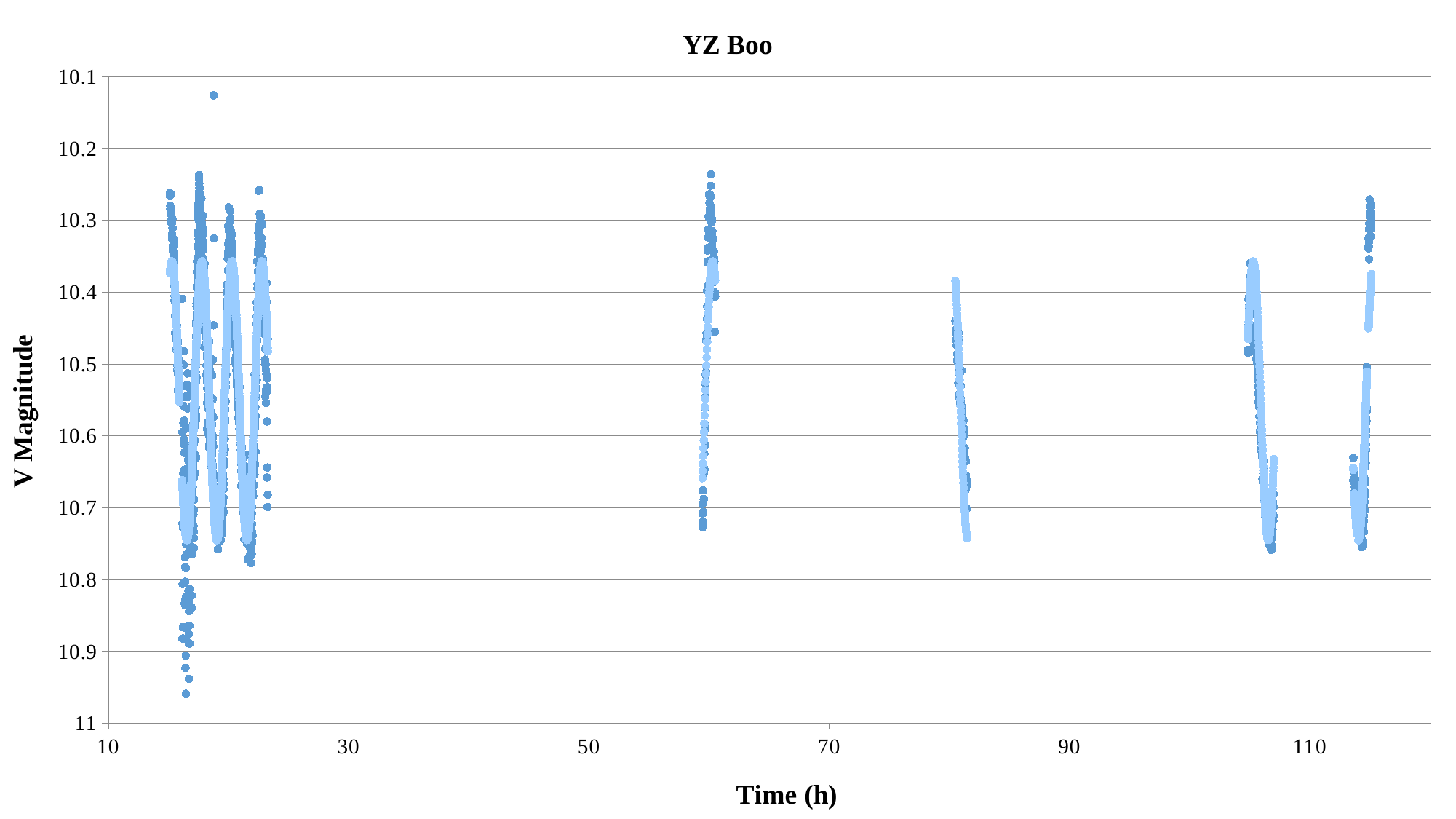
In which cluster does the largest V magnitude on the chart occur? the leftmost cluster Is the largest V magnitude in the cluster near 105-107 h greater or less than 10.7? greater What is the title of the chart? YZ Boo Is the largest V magnitude in the cluster near 60 h greater or less than 10.8? less Is the smallest V magnitude in the cluster near 81 h greater or less than 10.3? greater Which cluster reaches a smaller V magnitude, the one near 60 h or the one near 81 h? the cluster near 60 h How many labelled tick values are shown on the x axis? 6 What is the label on the y axis of the chart? V Magnitude How many separate groups (clusters) of observations are plotted along the time axis? 5 What kind of chart is shown on the slide? scatter plot